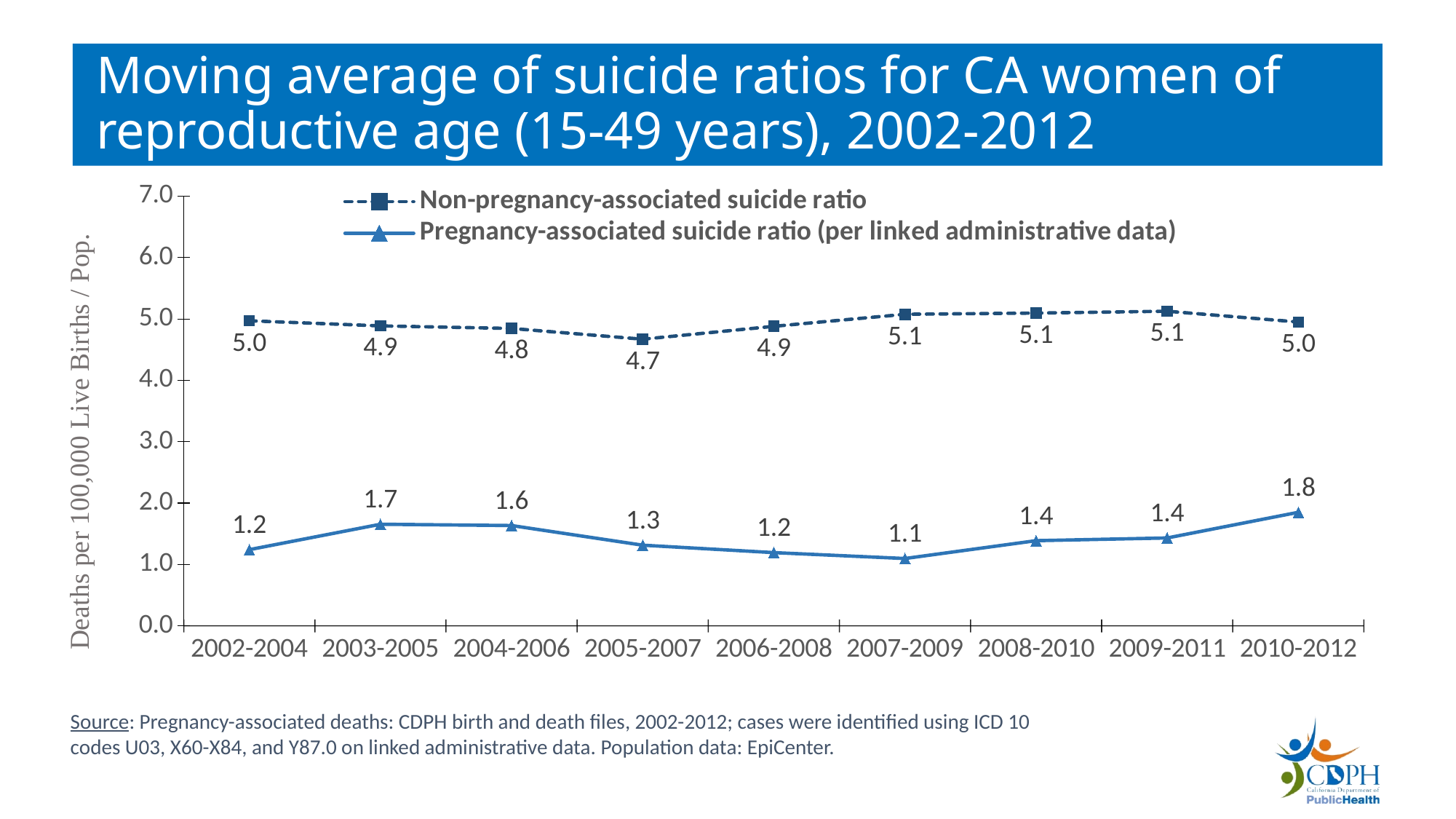
What is the non-pregnancy-associated suicide ratio for 2005-2007? 4.7 In which period is the pregnancy-associated suicide ratio highest? 2010-2012 What kind of chart is this? Line chart What is the y-axis label of the chart? Deaths per 100,000 Live Births / Pop. Which is larger, the pregnancy-associated suicide ratio in 2003-2005 or in 2006-2008? 2003-2005 How many series does the legend list? 2 What is the pregnancy-associated suicide ratio for 2003-2005? 1.7 In which period is the pregnancy-associated suicide ratio lowest? 2007-2009 In which period is the non-pregnancy-associated suicide ratio lowest? 2005-2007 How many periods are shown on the x axis? 9 What is the difference between the non-pregnancy-associated and pregnancy-associated suicide ratios in 2010-2012? 3.2 What is the pregnancy-associated suicide ratio for 2010-2012? 1.8